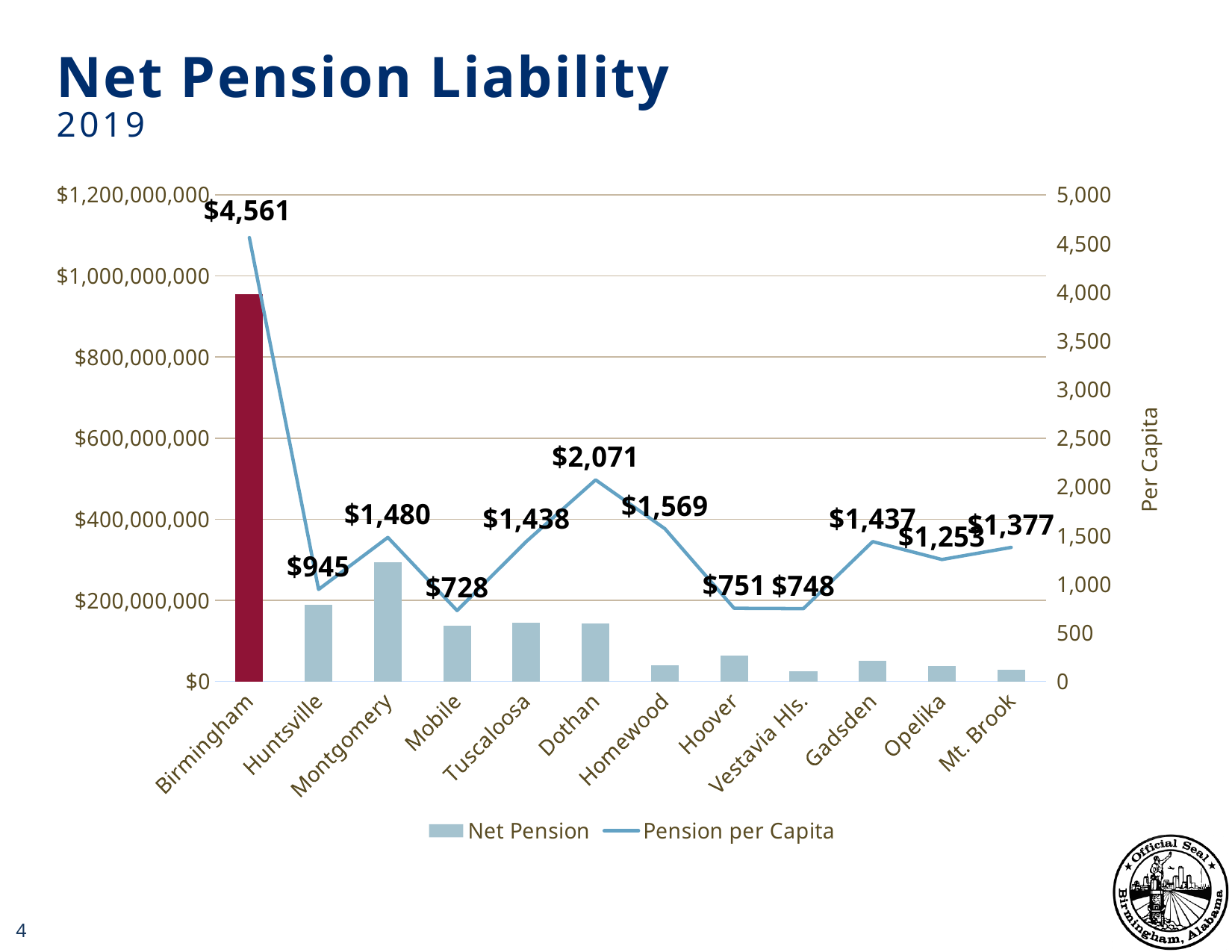
What is the difference between the Pension per Capita values for Dothan and Homewood? $502 What is the Pension per Capita value for Birmingham? $4,561 Is the Net Pension value for Montgomery greater or less than $200,000,000? greater How many cities are shown on the x axis? 12 Which city has the highest Net Pension bar? Birmingham What is the Pension per Capita value for Opelika? $1,253 What is the Pension per Capita value for Dothan? $2,071 What is the Pension per Capita value for Vestavia Hls.? $748 How many series does the legend list? 2 Which city has the lowest Pension per Capita? Mobile Which city has the highest Pension per Capita? Birmingham Which has a higher Pension per Capita, Montgomery or Tuscaloosa? Montgomery